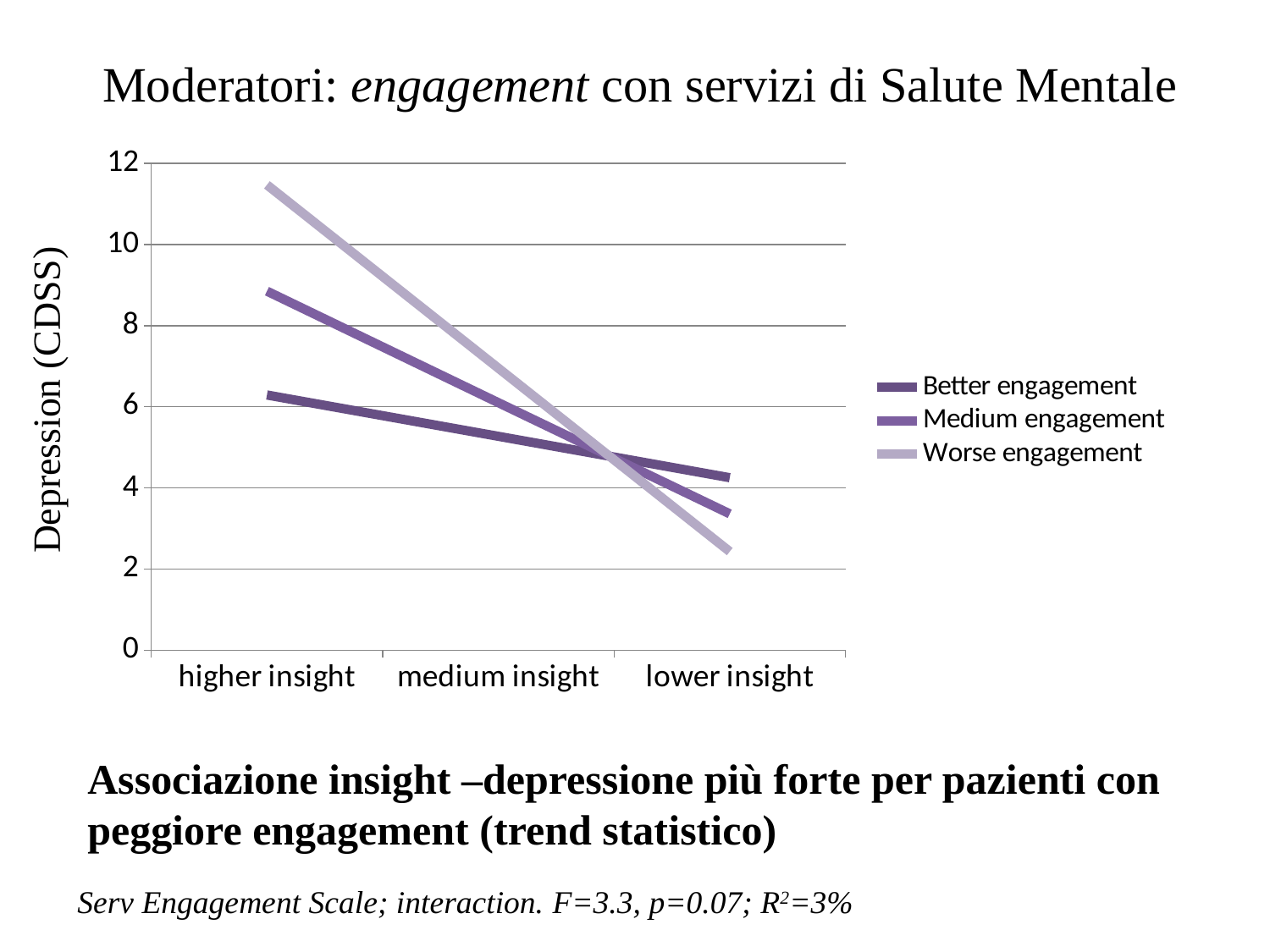
What kind of chart is shown on the slide? line chart Do the depression values for the Worse engagement series rise or fall from higher insight to lower insight? fall Which series has the lowest depression value at higher insight? Better engagement Is the value for Better engagement at lower insight greater or less than 6? less How many series does the legend list? 3 Is the value for Worse engagement at higher insight greater or less than 10? greater Which series has the highest depression value at higher insight? Worse engagement At lower insight, which is larger: the value for Better engagement or the value for Worse engagement? Better engagement What is the label of the y axis? Depression (CDSS) How many insight categories are shown on the x axis? 3 Is the value for Medium engagement at higher insight greater or less than 8? greater Which series has the lowest depression value at lower insight? Worse engagement